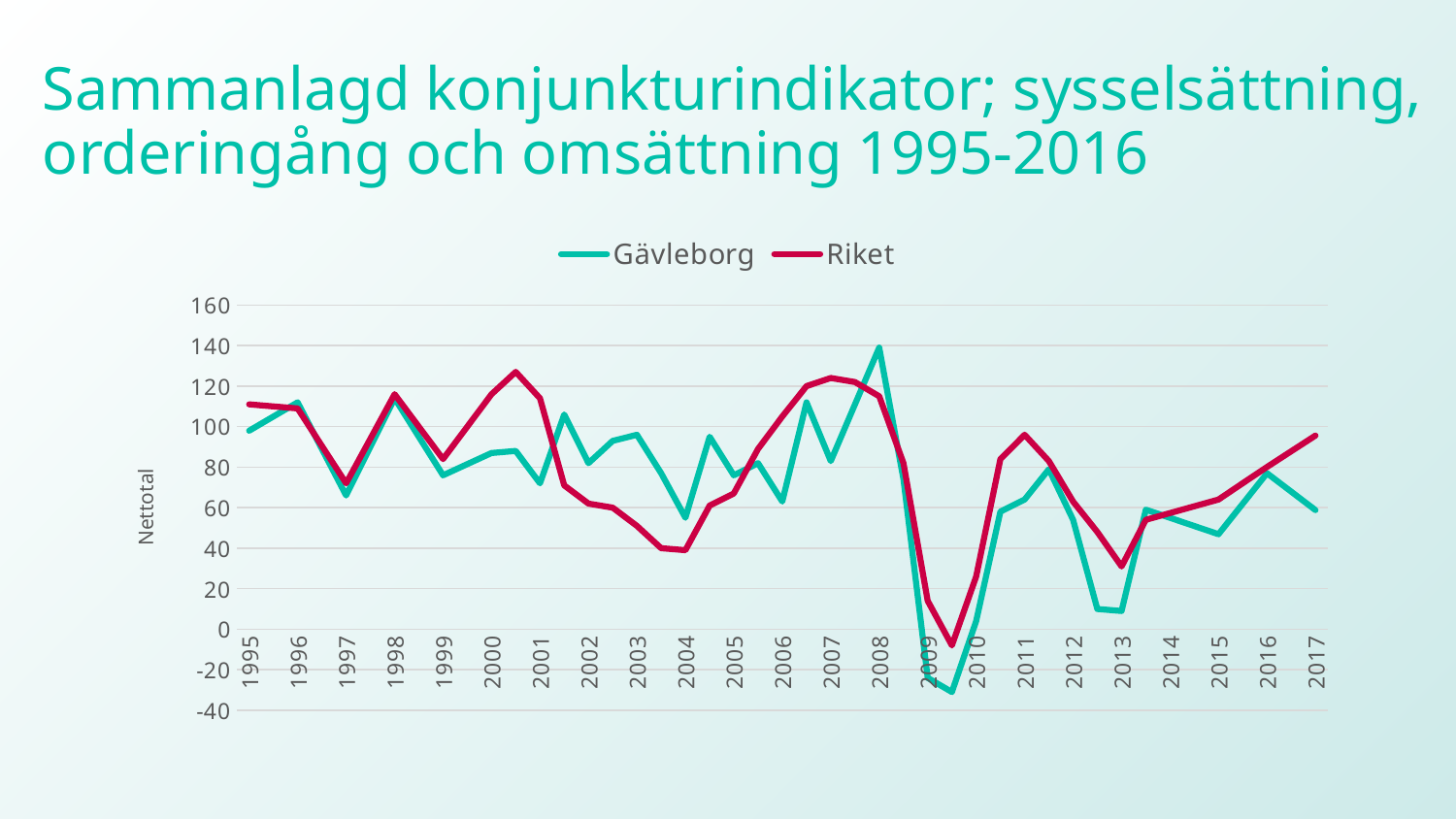
In which year does the Riket line reach its lowest value? 2009 Is the value for Gävleborg in 2009 greater or less than 0? less Which two series are listed in the legend? Gävleborg and Riket What is the label on the vertical axis? Nettotal Is the value for Gävleborg in 2013 greater or less than 20? less What kind of chart is shown on the slide? line chart Does the Riket line rise or fall from 2013 to 2017? rise How many years are labelled along the x axis? 23 How many series does the legend list? 2 In 2008, which series has the higher value, Gävleborg or Riket? Gävleborg In which year does the Gävleborg line reach its highest value? 2008